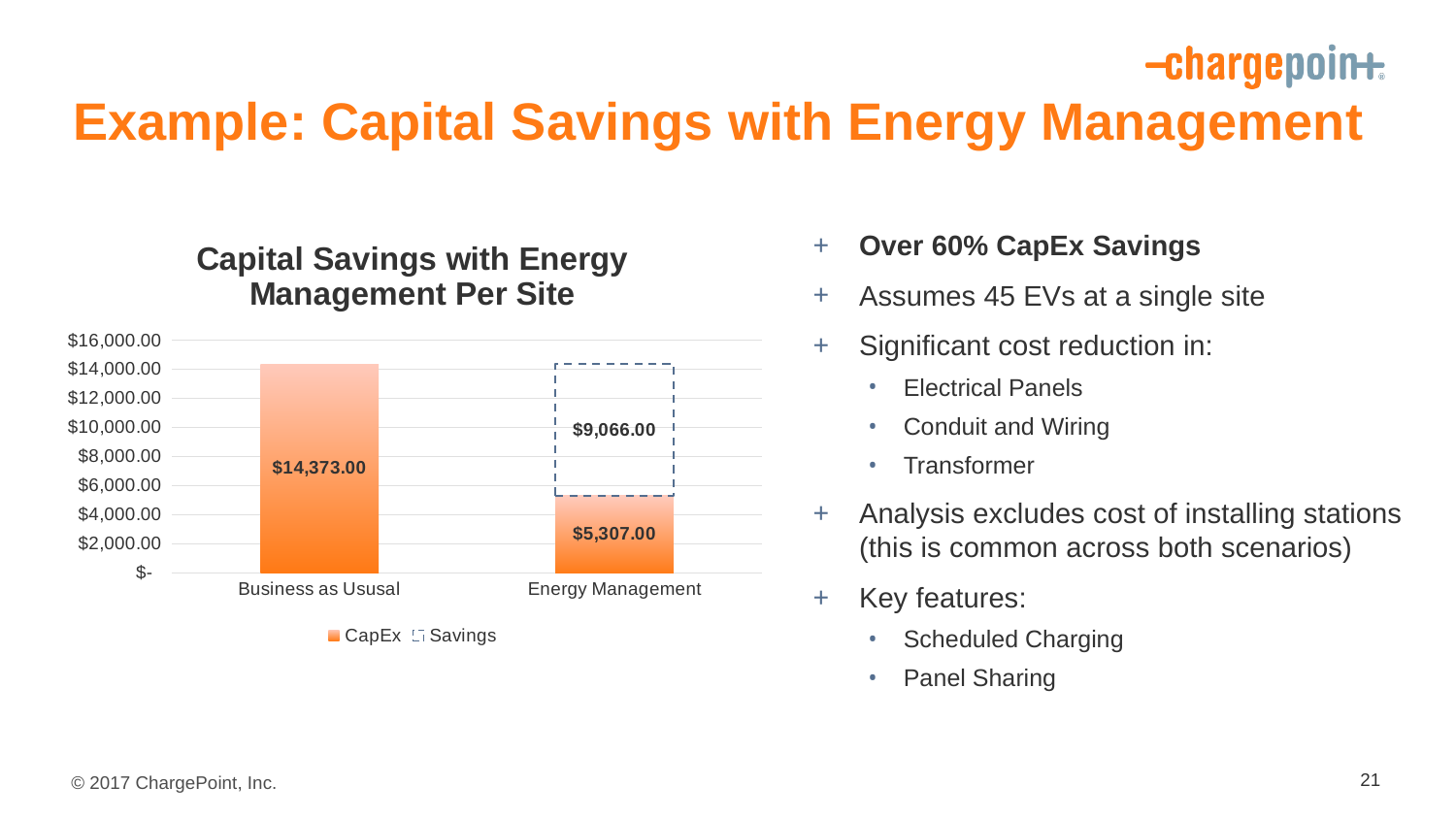
What kind of chart is shown on the slide? Stacked bar chart How many categories are shown on the x axis? 2 What is the total of the stacked bar for Energy Management (CapEx plus Savings)? $14,373.00 Which category has the higher CapEx value? Business as Ususal What is the difference between the CapEx for Business as Ususal and the CapEx for Energy Management? $9,066.00 Which category has the lower CapEx value? Energy Management Is the CapEx for Energy Management larger or smaller than the Savings for Energy Management? smaller What is the CapEx value for Energy Management? $5,307.00 What is the title of the chart? Capital Savings with Energy Management Per Site What is the CapEx value for Business as Ususal? $14,373.00 What is the Savings value for Energy Management? $9,066.00 How many series does the legend list? 2